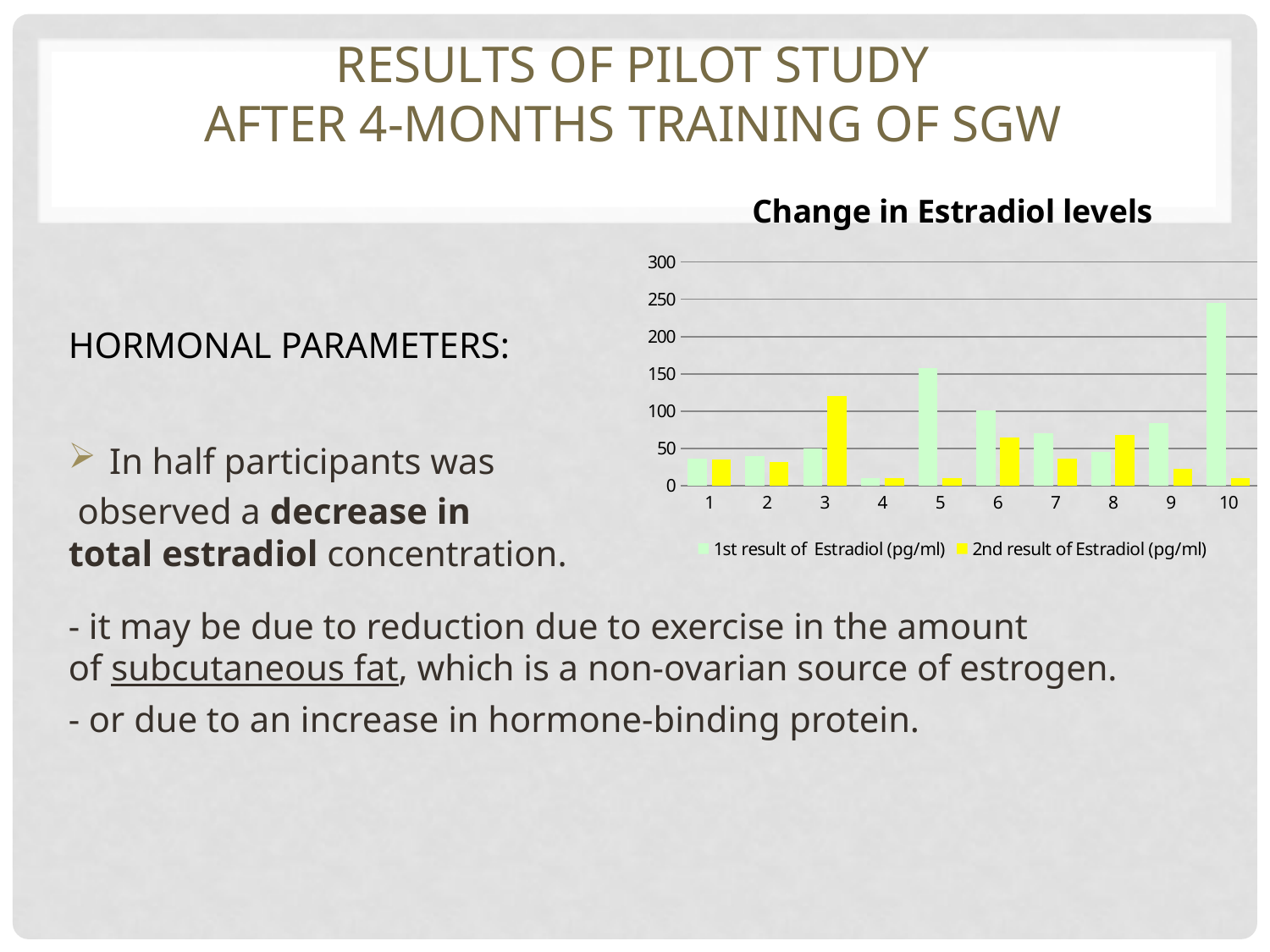
Is the 1st result of Estradiol for participant 10 greater or less than 200? greater Is the 2nd result of Estradiol for participant 10 greater or less than 50? less What kind of chart is shown on the slide? bar chart What is the title of the chart? Change in Estradiol levels For participant 3, which is larger: the 1st result or the 2nd result of Estradiol? 2nd result Which participant has the highest 1st result of Estradiol (pg/ml)? 10 Is the 2nd result of Estradiol for participant 3 greater or less than 100? greater How many series does the chart's legend list? 2 For participant 5, which is larger: the 1st result or the 2nd result of Estradiol? 1st result How many participants (categories) are shown on the x axis of the chart? 10 Which participant has the highest 2nd result of Estradiol (pg/ml)? 3